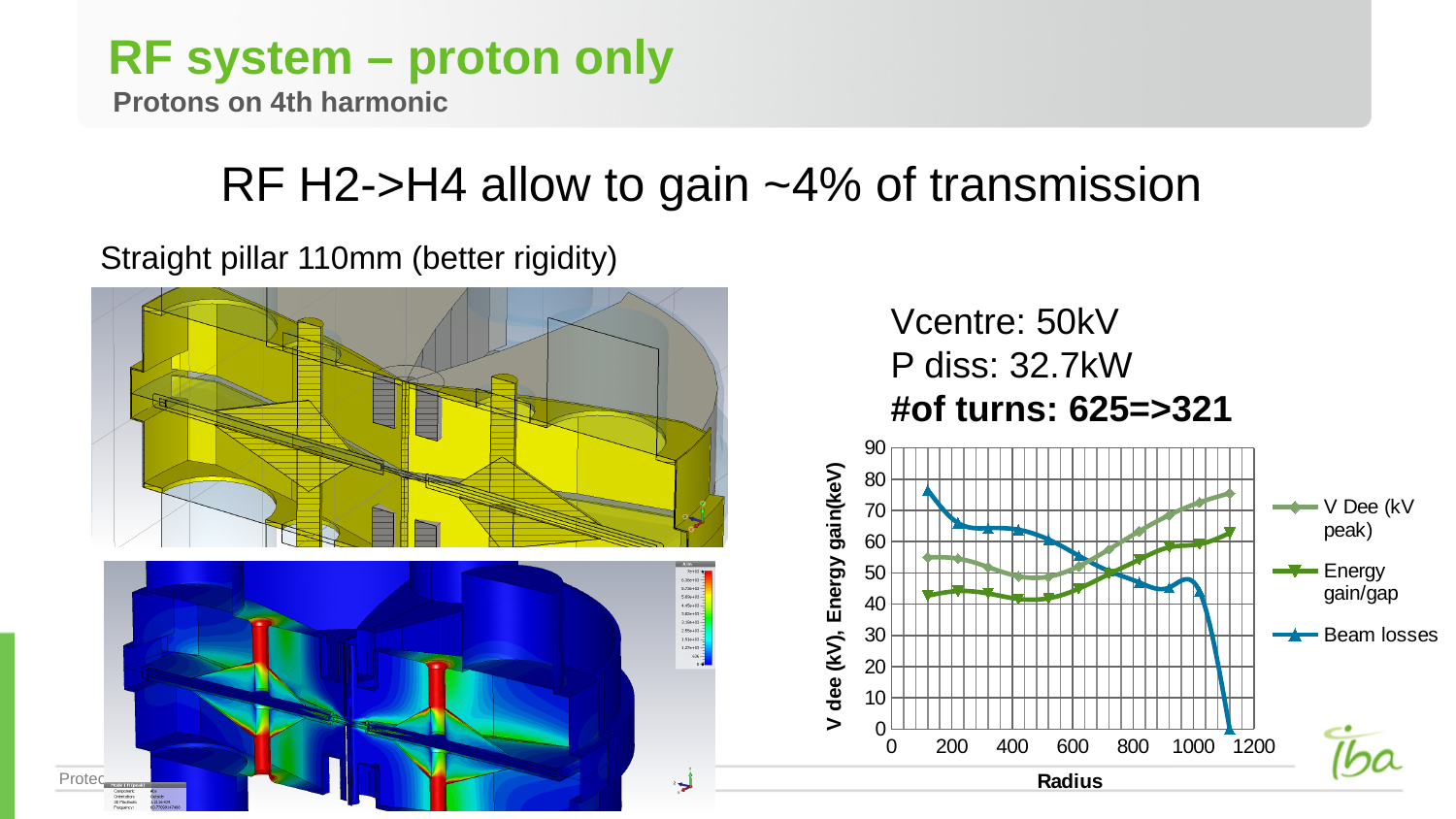
Which series has the highest value at radius 100? Beam losses Does the Beam losses series generally rise or fall as radius increases from 100 to 1100? fall Is the V Dee (kV peak) value at radius 1100 greater or less than 70? greater At radius 200, which series has the higher value: Beam losses or Energy gain/gap? Beam losses What is the title of the chart's x axis? Radius Is the Beam losses value at radius 100 greater or less than 70? greater Does the V Dee (kV peak) series rise or fall between radius 600 and radius 1100? rise What are the three series named in the chart legend? V Dee (kV peak), Energy gain/gap, Beam losses How many series does the chart legend list? 3 Is the Energy gain/gap value at radius 400 greater or less than 50? less At radius 1100, which series has the higher value: V Dee (kV peak) or Energy gain/gap? V Dee (kV peak) What kind of chart is shown on the slide? line chart